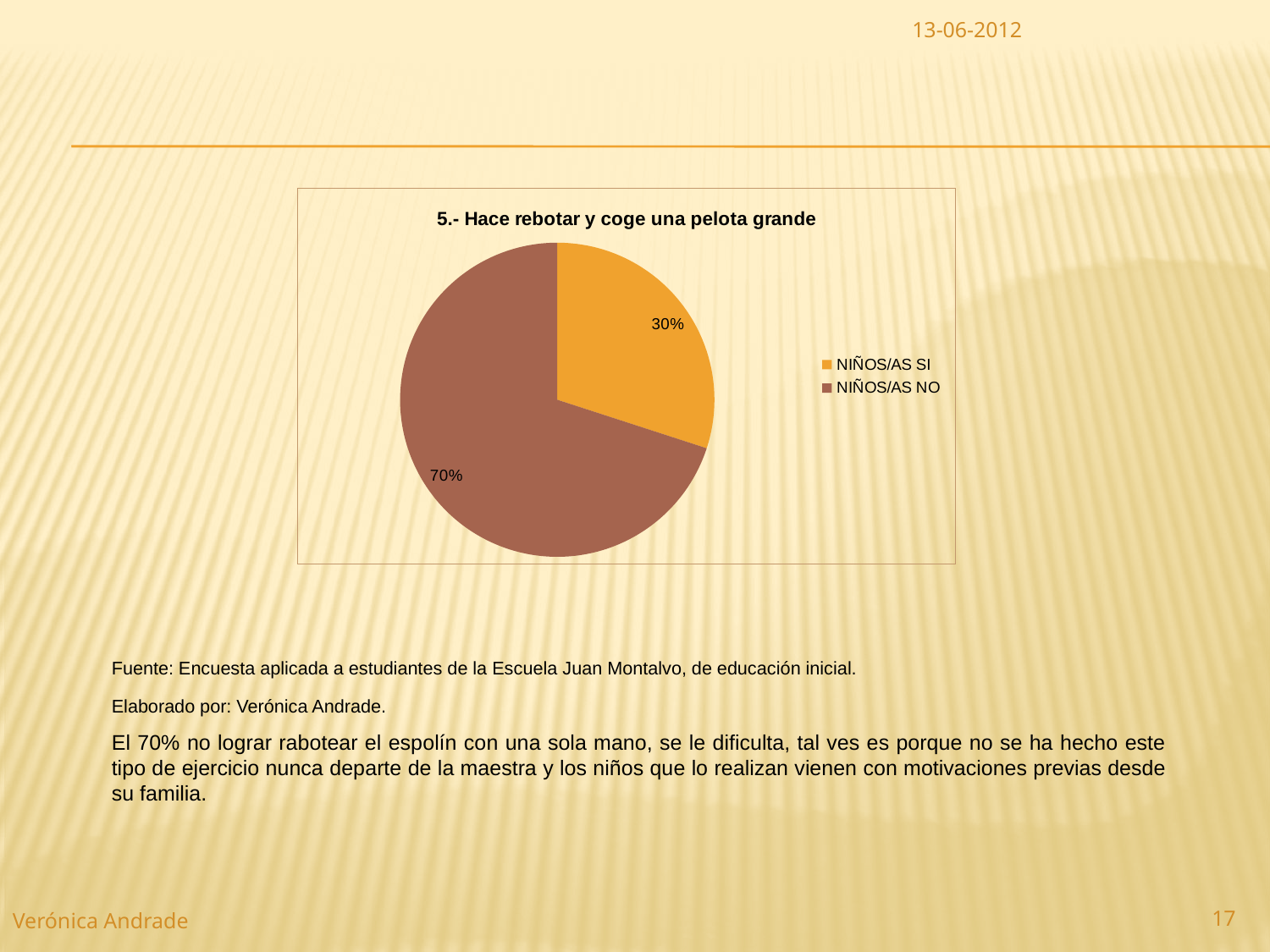
What is the title of the chart? 5.- Hace rebotar y coge una pelota grande What percentage of the pie is labelled NIÑOS/AS NO? 70% How many entries does the legend list? 2 Which category has the largest share of the pie? NIÑOS/AS NO What colour is the slice for NIÑOS/AS SI? orange What is the difference in percentage points between NIÑOS/AS NO and NIÑOS/AS SI? 40 How many slices does the pie chart have? 2 What share of the pie does the NIÑOS/AS NO slice represent? 70% Which is larger, the share for NIÑOS/AS SI or the share for NIÑOS/AS NO? NIÑOS/AS NO Which category has the smallest share of the pie? NIÑOS/AS SI What type of chart is shown on the slide? pie chart What percentage of the pie is labelled NIÑOS/AS SI? 30%